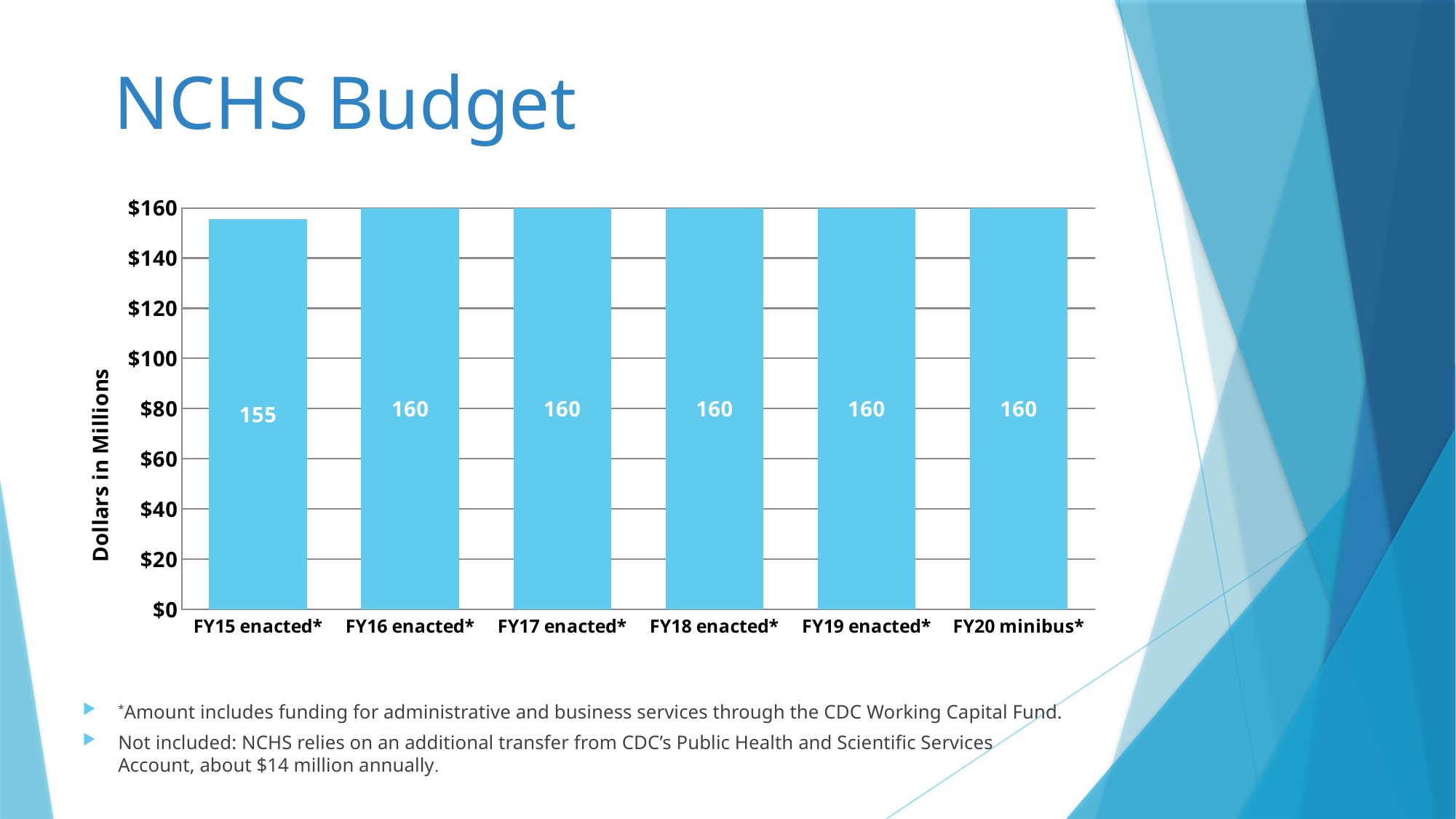
What is the value for FY15 enacted*? 155 What is the value for FY20 minibus*? 160 What is the title of the slide containing the chart? NCHS Budget How many categories are shown on the x axis? 6 What is the label of the vertical axis? Dollars in Millions What is the difference between the values for FY16 enacted* and FY15 enacted*? 5 Do the values rise or fall from FY15 enacted* to FY16 enacted*? rise Is the value for FY19 enacted* greater or less than $140? greater Which category has the lowest value? FY15 enacted* What kind of chart is shown on the slide? bar chart Which is larger, the value for FY15 enacted* or FY17 enacted*? FY17 enacted* What is the value for FY18 enacted*? 160